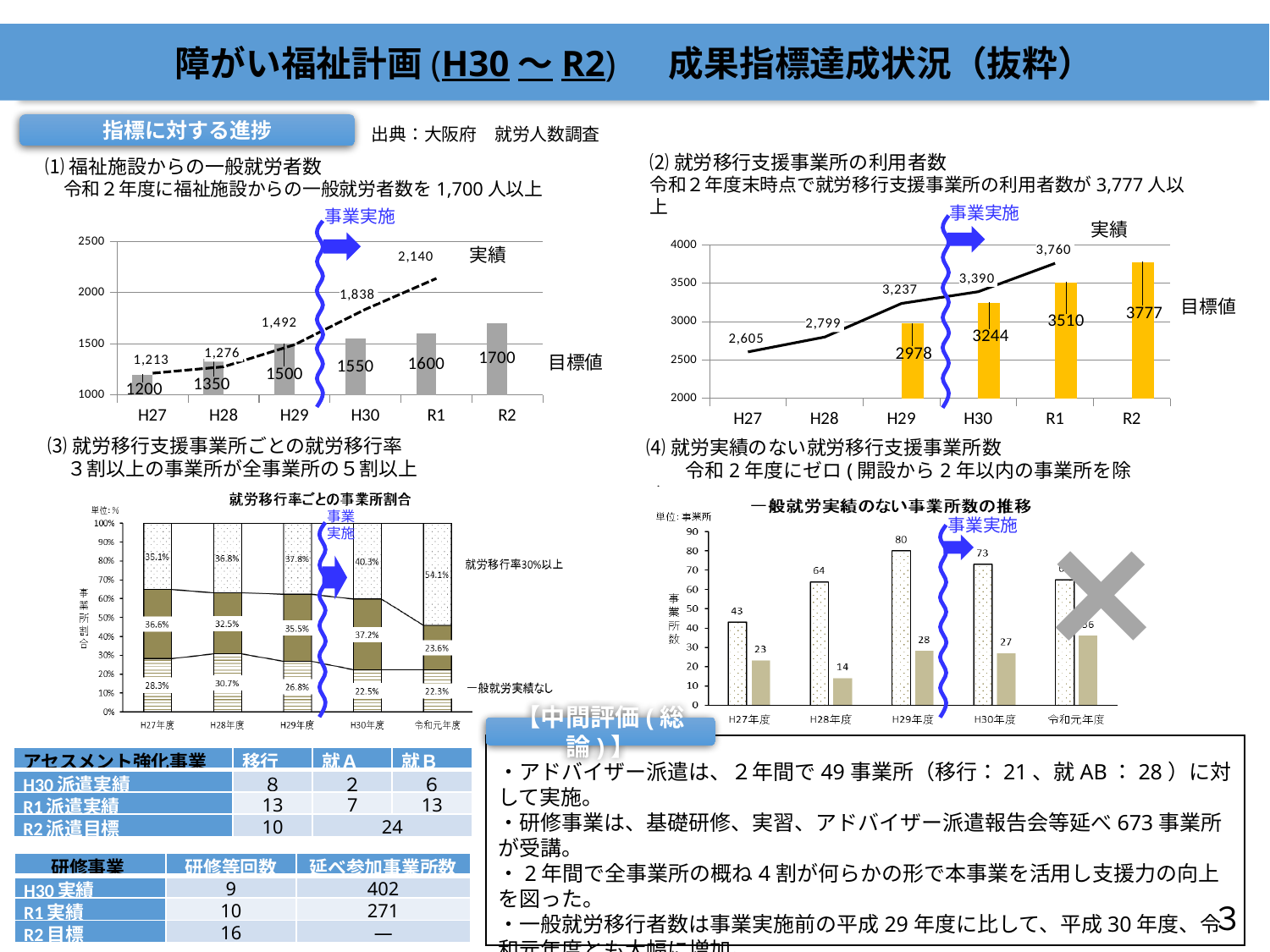
In the chart for (1) 福祉施設からの一般就労者数, what is the difference between the 実績 for R1 (2,140) and the 実績 for H30 (1,838)? 302 In the chart titled 一般就労実績のない事業所数の推移, which year has the highest value for the taller (dotted) bar series? H29年度 In the chart for (2) 就労移行支援事業所の利用者数, how many 目標値 bars are shown? 4 In the chart for (1) 福祉施設からの一般就労者数, what is the 目標値 for R2? 1700 In the chart titled 就労移行率ごとの事業所割合, what is the share of 一般就労実績なし for H28年度? 30.7% In the chart for (1) 福祉施設からの一般就労者数, what is the 実績 value for H30? 1,838 In the chart for (2) 就労移行支援事業所の利用者数, what is the 目標値 for R2? 3777 In the chart for (2) 就労移行支援事業所の利用者数, which is larger for R1: the 実績 (3,760) or the 目標値 (3510)? 実績 (3,760) In the chart titled 一般就労実績のない事業所数の推移, what is the value of the shorter bar for H28年度? 14 In the chart for (1) 福祉施設からの一般就労者数, does the 実績 line rise or fall from H27 to R1? rise In the chart titled 就労移行率ごとの事業所割合, what is the share of 就労移行率30%以上 for 令和元年度? 54.1% In the chart for (2) 就労移行支援事業所の利用者数, what is the 実績 value for H29? 3,237